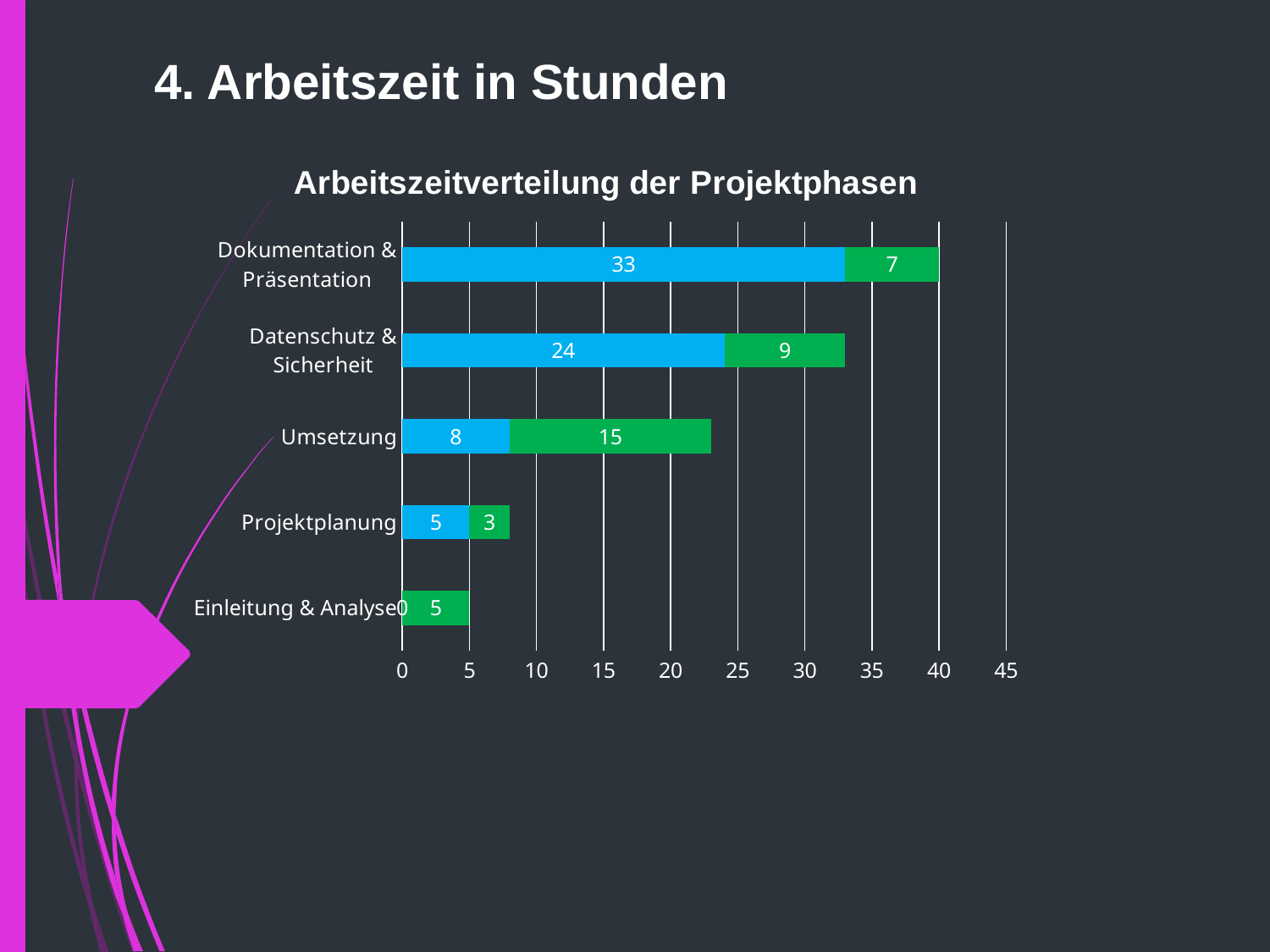
Which project phase has the longest total bar? Dokumentation & Präsentation What is the value of the blue segment for Einleitung & Analyse? 0 What is the value of the blue segment for Datenschutz & Sicherheit? 24 Which has the larger green segment, Umsetzung or Datenschutz & Sicherheit? Umsetzung What is the total of the stacked bar for Umsetzung? 23 What is the difference between the blue segment of Dokumentation & Präsentation and the blue segment of Datenschutz & Sicherheit? 9 What is the total of the stacked bar for Dokumentation & Präsentation? 40 What is the value of the green segment for Umsetzung? 15 How many project phases (categories) are shown on the chart? 5 Which project phase has the shortest total bar? Einleitung & Analyse What is the title of the chart? Arbeitszeitverteilung der Projektphasen What kind of chart is shown on the slide? bar chart